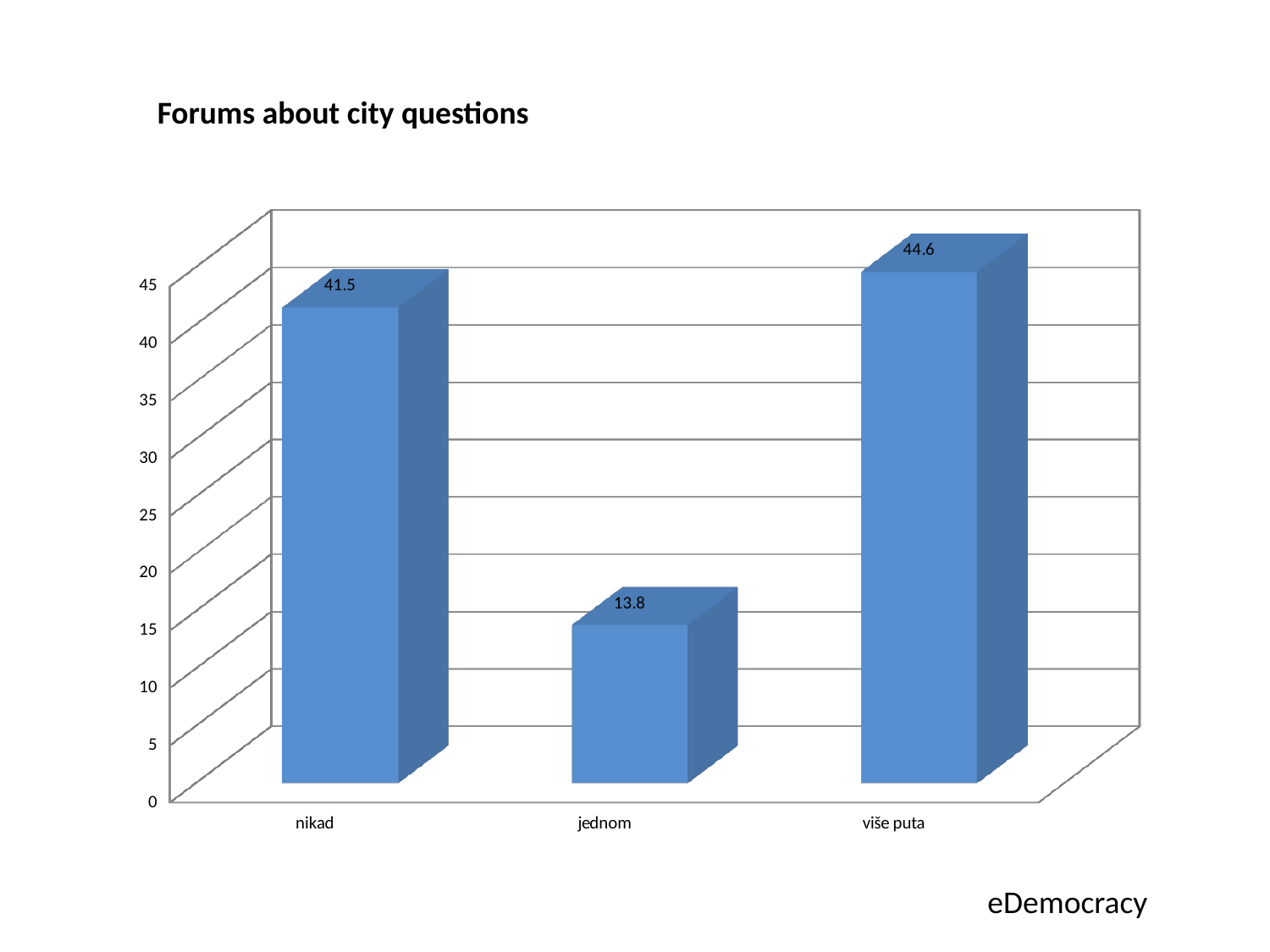
What kind of chart is shown on the slide? bar chart Which category has the lowest value? jednom What is the difference between the values for više puta and nikad? 3.1 What is the value for nikad? 41.5 What is the value for više puta? 44.6 Which category has the highest value? više puta Is the value for jednom greater or less than 20? less What is the value for jednom? 13.8 What is the difference between the values for nikad and jednom? 27.7 What is the title of the chart? Forums about city questions Which is larger, the value for nikad or the value for jednom? nikad How many categories are shown on the x axis? 3